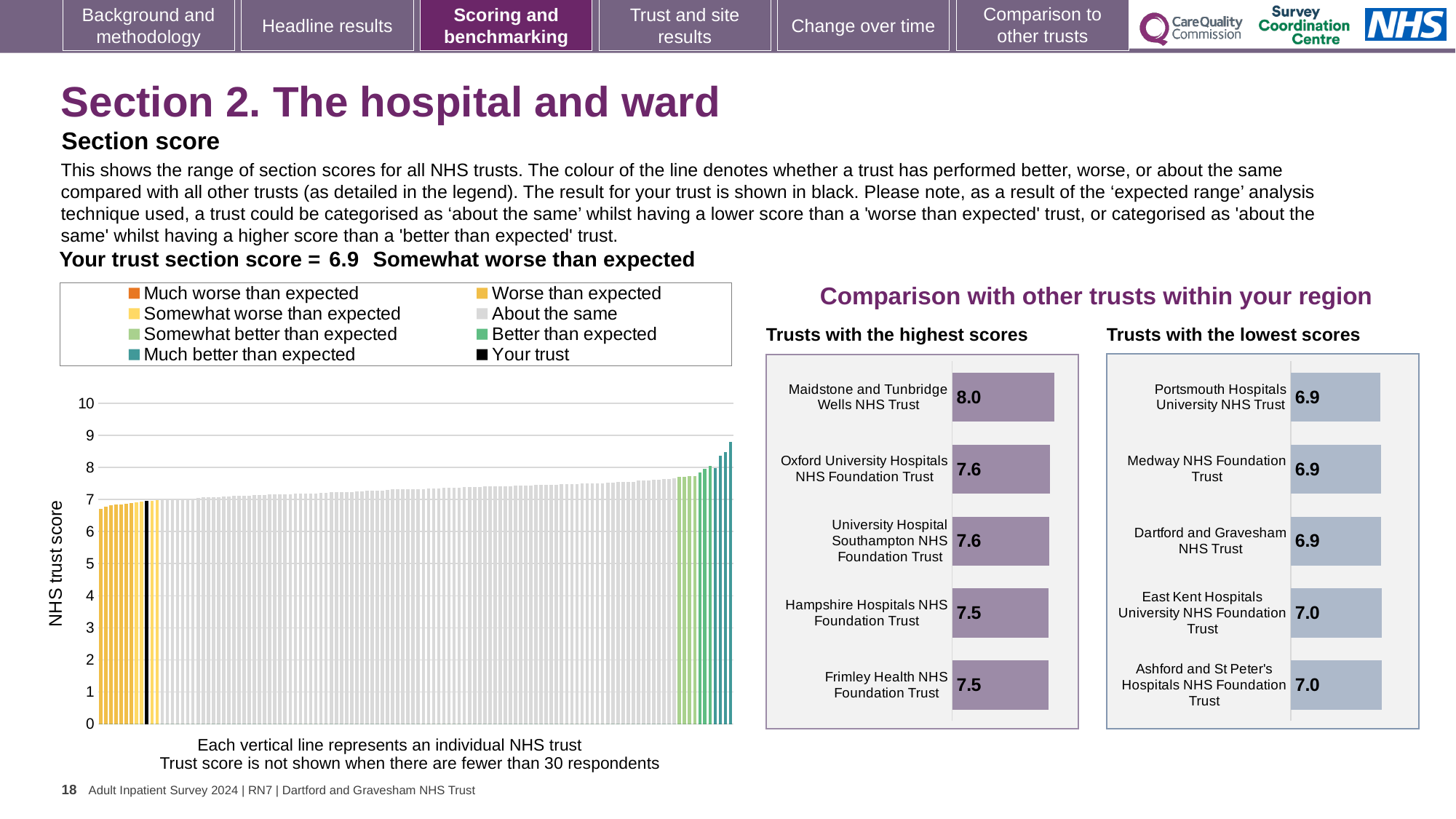
In the 'Trusts with the highest scores' chart, what is the score for Hampshire Hospitals NHS Foundation Trust? 7.5 What type of chart is the large chart on the left showing NHS trust scores? Bar chart In the large chart on the left, do the NHS trust scores rise or fall from left to right? Rise In the 'Trusts with the lowest scores' chart, what is the score for East Kent Hospitals University NHS Foundation Trust? 7.0 In the 'Trusts with the highest scores' chart, what is the difference between the scores of Maidstone and Tunbridge Wells NHS Trust and Frimley Health NHS Foundation Trust? 0.5 In the 'Trusts with the lowest scores' chart, which is larger: the score for Portsmouth Hospitals University NHS Trust or the score for Ashford and St Peter's Hospitals NHS Foundation Trust? Ashford and St Peter's Hospitals NHS Foundation Trust In the 'Trusts with the highest scores' chart, which trust has the highest score? Maidstone and Tunbridge Wells NHS Trust How many trusts are shown in the 'Trusts with the lowest scores' chart? 5 How many entries does the legend of the large chart on the left list? 8 In the 'Trusts with the highest scores' chart, what is the score for Maidstone and Tunbridge Wells NHS Trust? 8.0 In the large chart on the left, is the value for the black 'Your trust' bar greater or less than 8? less In the 'Trusts with the lowest scores' chart, what is the score for Dartford and Gravesham NHS Trust? 6.9